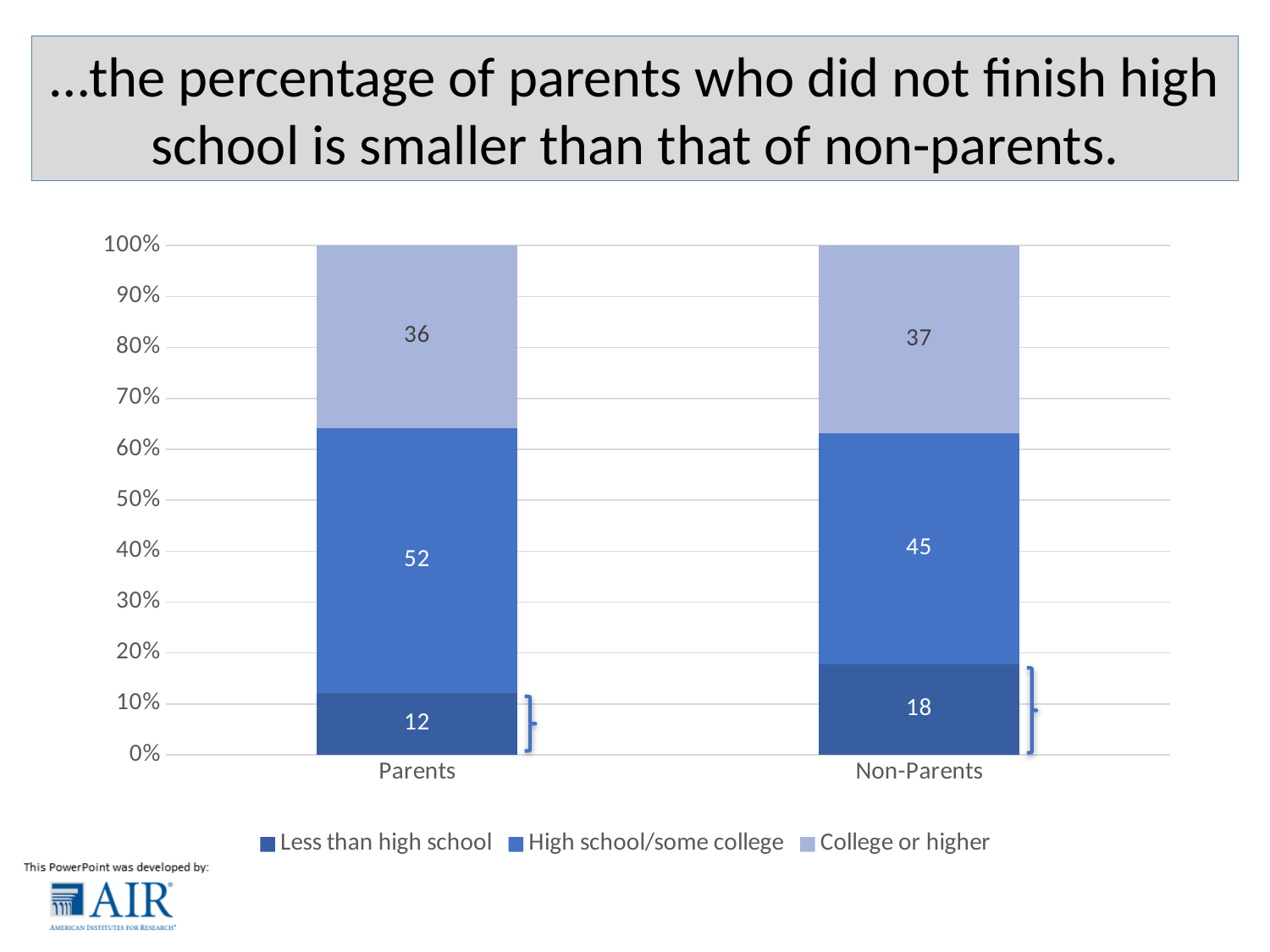
How many categories are shown on the x axis? 2 What is the value for College or higher for Non-Parents? 37 What kind of chart is shown on the slide? Stacked bar chart What is the difference between the High school/some college values for Parents and Non-Parents? 7 What is the value for High school/some college for Parents? 52 How many series does the legend list? 3 Which category has the larger Less than high school value, Parents or Non-Parents? Non-Parents What is the value for Less than high school for Parents? 12 What is the total of the stacked bar for Parents? 100 What is the difference between the Less than high school values for Non-Parents and Parents? 6 Which category has the larger High school/some college value, Parents or Non-Parents? Parents What is the value for Less than high school for Non-Parents? 18